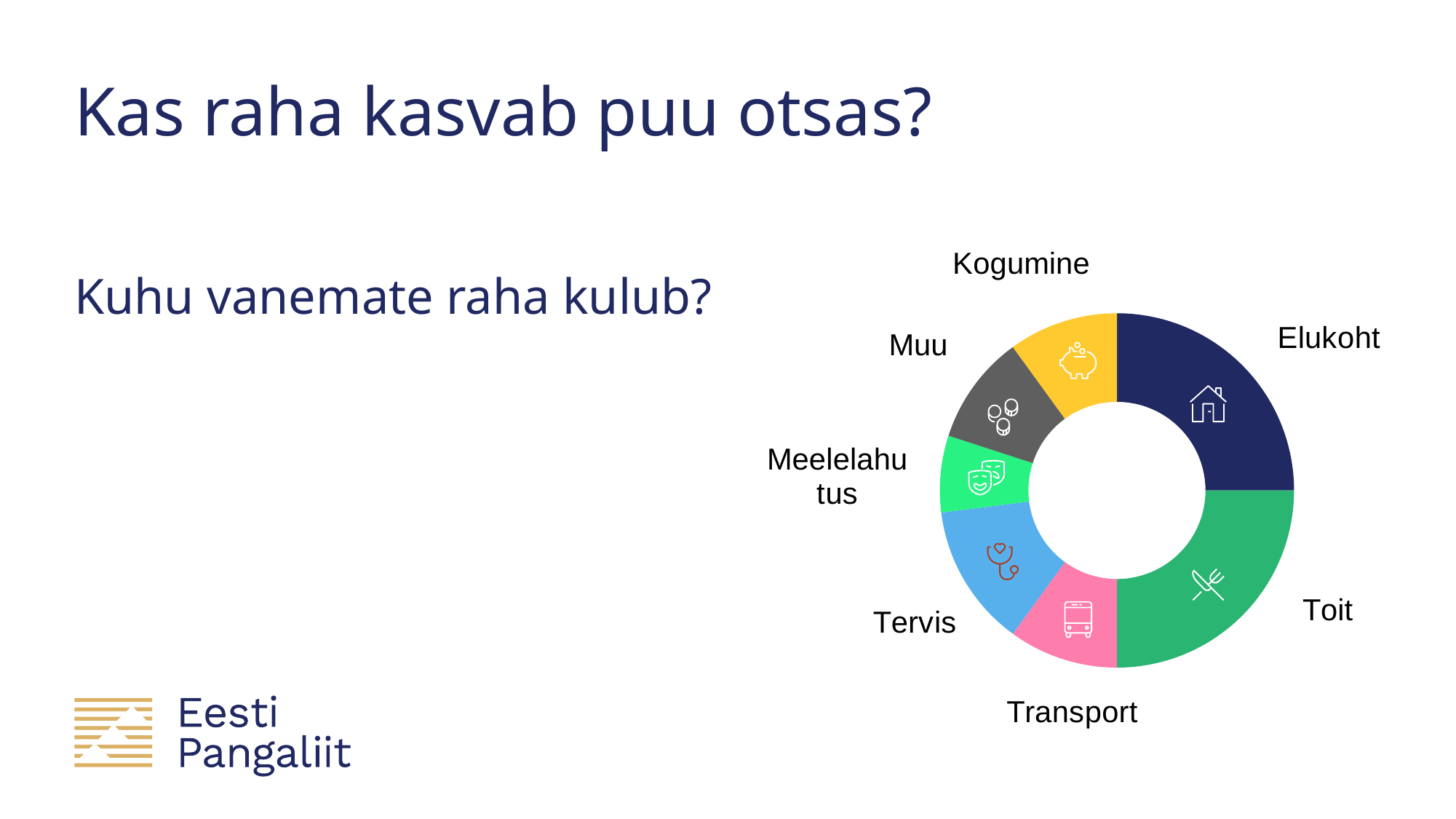
Which is larger in the pie chart, Tervis or Meelelahutus? Tervis What question serves as the title of the pie chart? Kuhu vanemate raha kulub? What kind of chart is shown on the slide? Pie chart (donut) Which is larger in the pie chart, Elukoht or Transport? Elukoht Which is larger in the pie chart, Toit or Tervis? Toit How many categories does the pie chart show? 7 What colour is the Elukoht slice in the pie chart? Dark navy blue